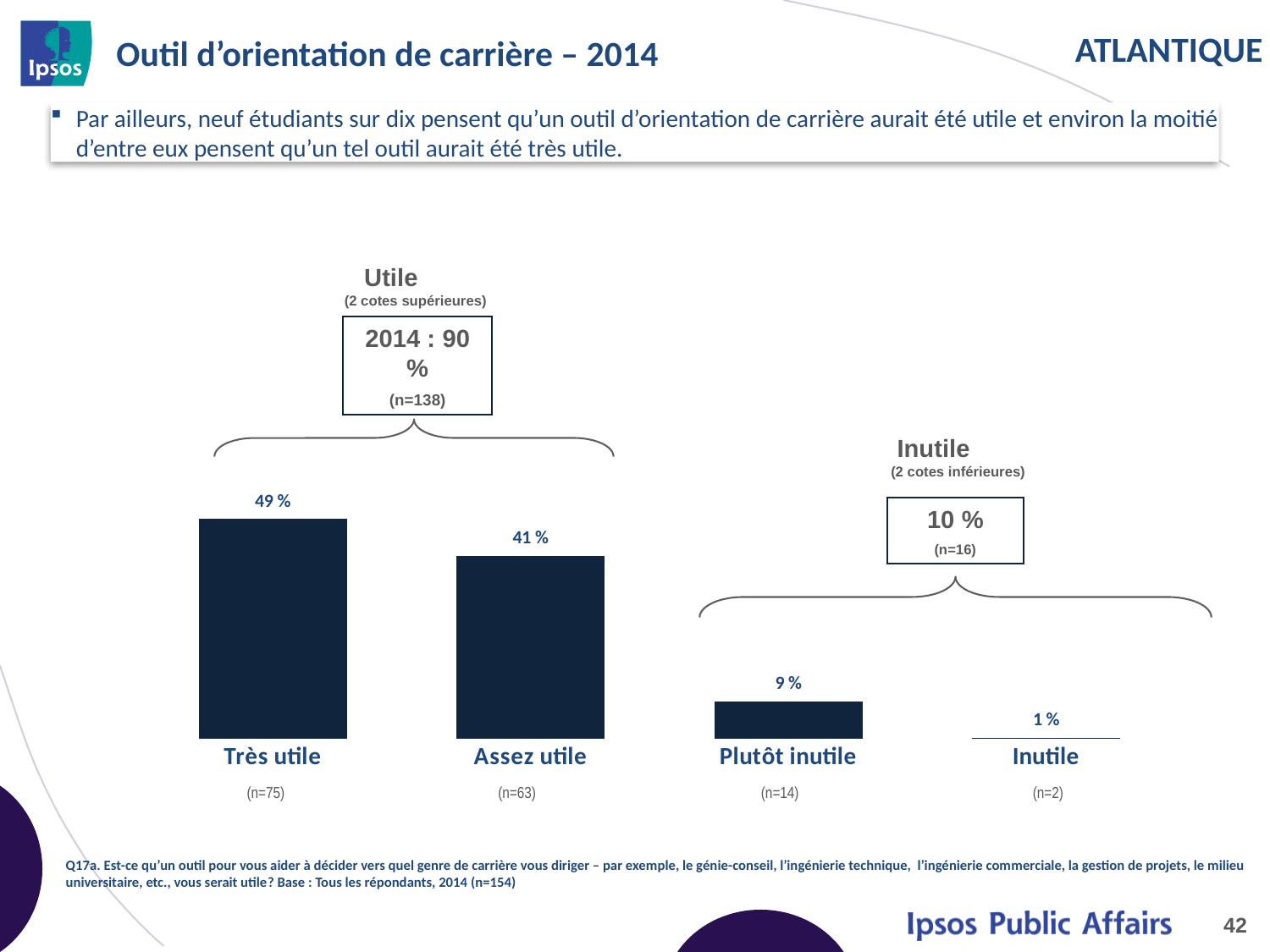
What kind of chart is shown on the slide? Bar chart Which is larger, the value for Plutôt inutile or the value for Inutile? Plutôt inutile How many categories are shown in the chart? 4 What is the value for Inutile? 1 % What is the value for Assez utile? 41 % What is the sample size (n) shown under the Très utile bar? n=75 What is the value for Plutôt inutile? 9 % Which category has the lowest value? Inutile Which category has the highest value? Très utile What combined percentage is shown for Utile (2 cotes supérieures) in 2014? 90 % What is the value for Très utile? 49 % What is the difference between the values for Très utile and Assez utile? 8 %